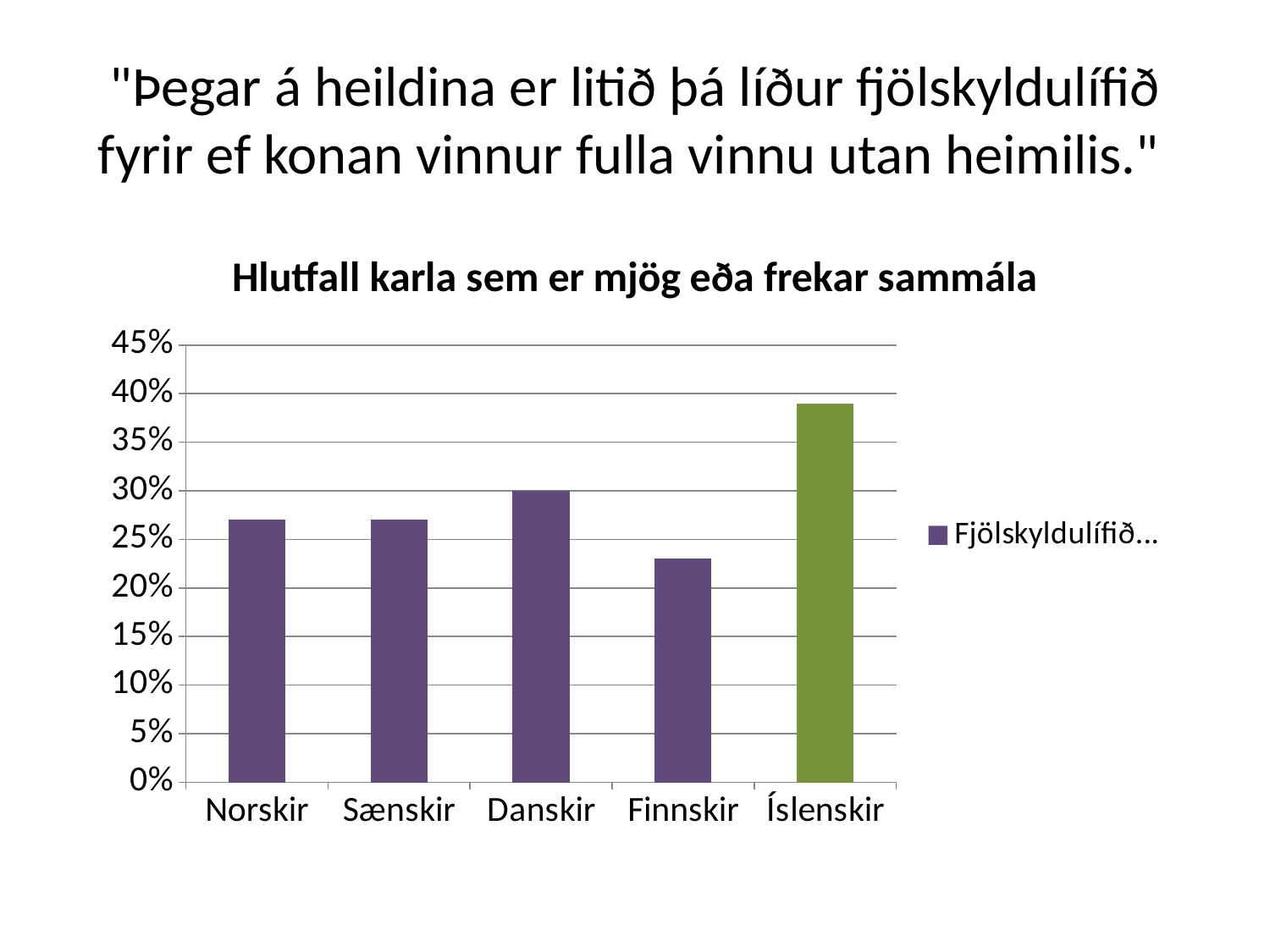
Which has a larger value, Íslenskir or Danskir? Íslenskir Is the value for Íslenskir greater or less than 35%? greater How many categories (nationalities) are shown on the x axis of the chart? 5 Which category has the highest value in the chart? Íslenskir Is the value for Norskir greater or less than 25%? greater Is the value for Finnskir greater or less than 25%? less What is the title of the chart? Hlutfall karla sem er mjög eða frekar sammála What kind of chart is shown on the slide? bar chart How many series does the chart's legend list? 1 Which category's bar is coloured green rather than purple? Íslenskir Which has a larger value, Danskir or Finnskir? Danskir Which category has the lowest value in the chart? Finnskir